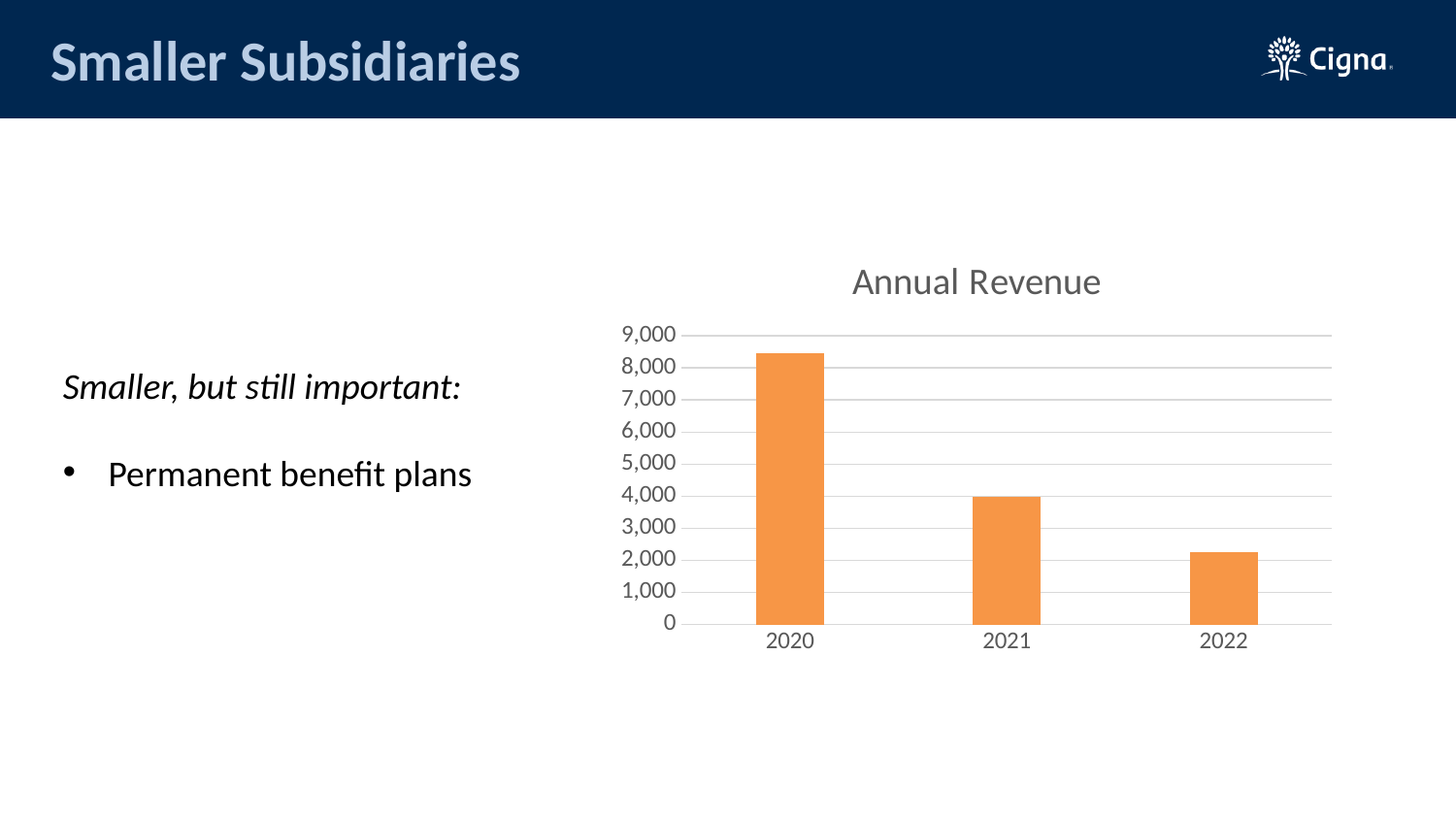
What kind of chart is shown on the slide? bar chart What is the title of the chart? Annual Revenue Is the annual revenue for 2022 greater or less than 3,000? less Which is larger, the annual revenue for 2021 or for 2022? 2021 Which year has the lowest annual revenue? 2022 What colour are the bars in the Annual Revenue chart? orange Which year has the highest annual revenue? 2020 Is the annual revenue for 2022 greater or less than 2,000? greater Is the annual revenue for 2020 greater or less than 8,000? greater Do the annual revenue values rise or fall from 2020 to 2022? fall How many years are shown on the x axis of the Annual Revenue chart? 3